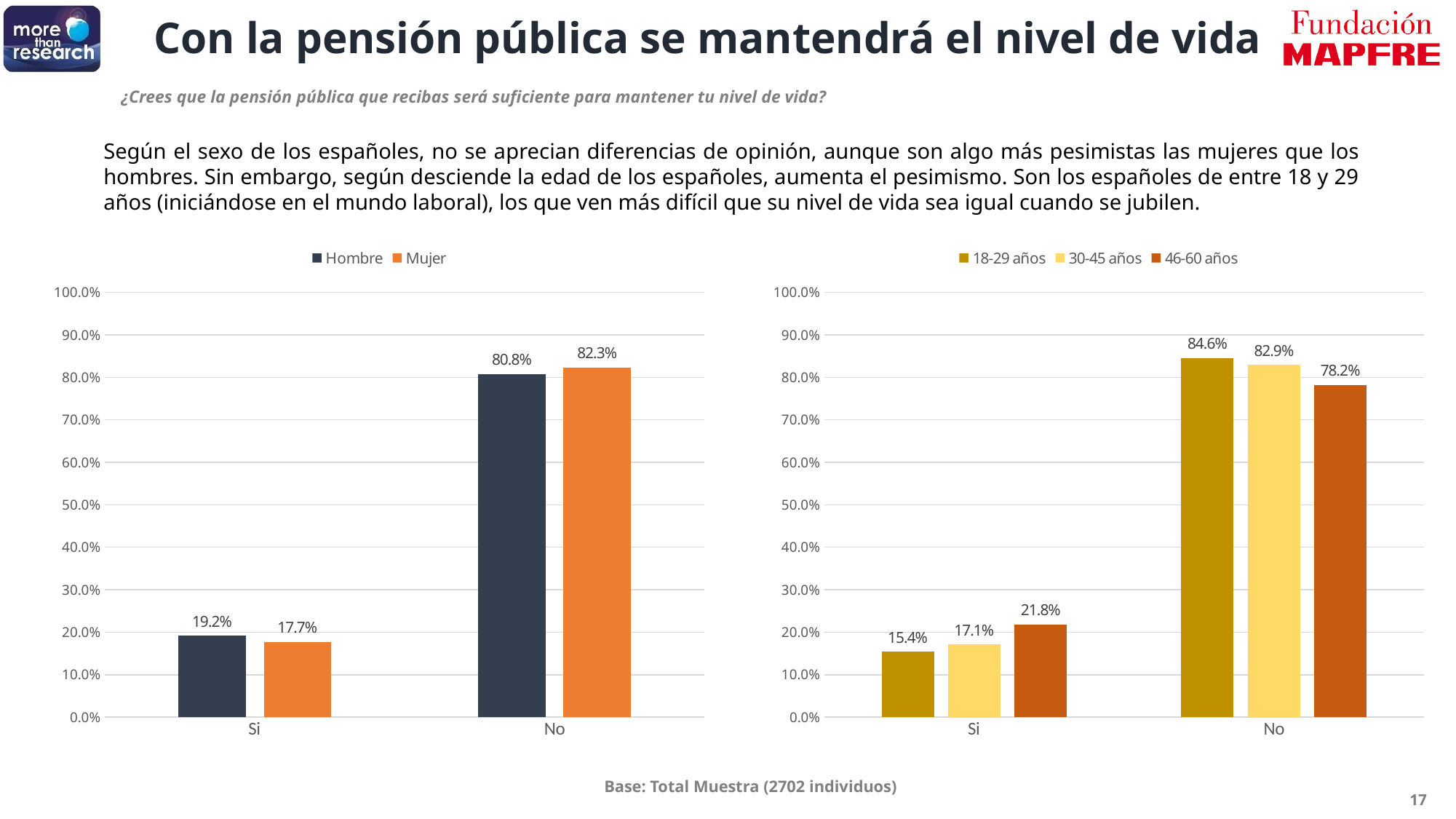
In the left chart (Hombre/Mujer), what is the value for Hombre in the 'No' category? 80.8% In the left chart (Hombre/Mujer), what is the difference between the Mujer and Hombre values in the 'No' category? 1.5% How many categories are shown on the x axis of the right chart (age groups)? 2 In the right chart (age groups), what is the value for 18-29 años in the 'No' category? 84.6% What kind of chart is the left chart (Hombre/Mujer)? Bar chart In the right chart (age groups), which age group has the lowest value in the 'Si' category? 18-29 años In the right chart (age groups), what is the value for 46-60 años in the 'Si' category? 21.8% In the right chart (age groups), which age group has the highest value in the 'No' category? 18-29 años In the left chart (Hombre/Mujer), what is the value for Mujer in the 'Si' category? 17.7% In the right chart (age groups), what is the difference between the 18-29 años and 46-60 años values in the 'No' category? 6.4% In the left chart (Hombre/Mujer), which is larger in the 'Si' category: Hombre or Mujer? Hombre How many series does the legend of the right chart (age groups) list? 3